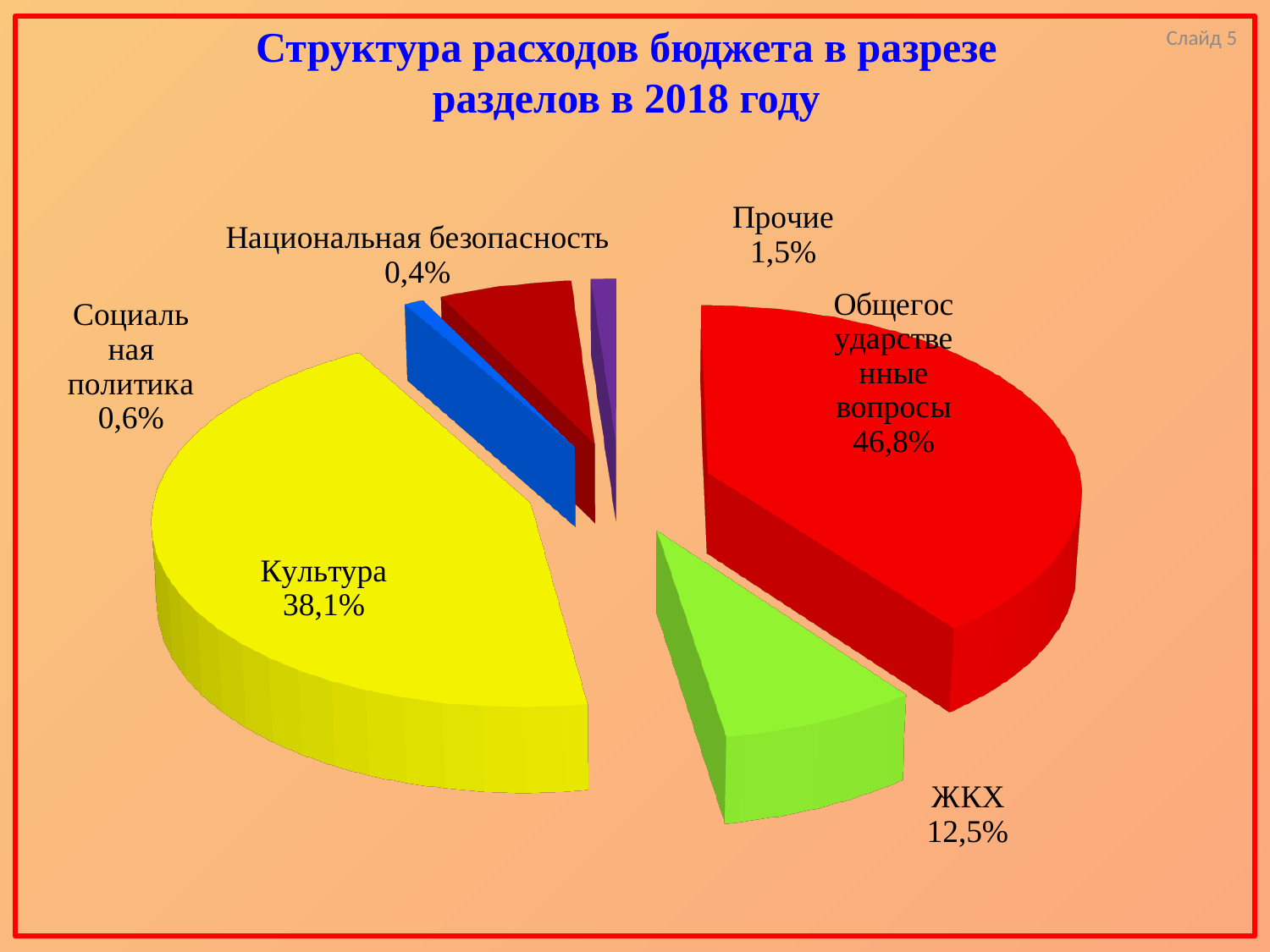
What share of the budget expenditure is ЖКХ? 12,5% How many slices does the pie chart have? 6 What is the difference in percentage points between Общегосударственные вопросы and Культура? 8,7 Which section has the largest share of budget expenditure? Общегосударственные вопросы What share of the budget expenditure is Национальная безопасность? 0,4% What share of the budget expenditure is Общегосударственные вопросы? 46,8% What kind of chart is shown on the slide? pie chart What is the title of the chart? Структура расходов бюджета в разрезе разделов в 2018 году Which section has the smallest share of budget expenditure? Национальная безопасность What share of the budget expenditure is Культура? 38,1% Which is larger, the share for ЖКХ or the share for Прочие? ЖКХ What share of the budget expenditure is Прочие? 1,5%